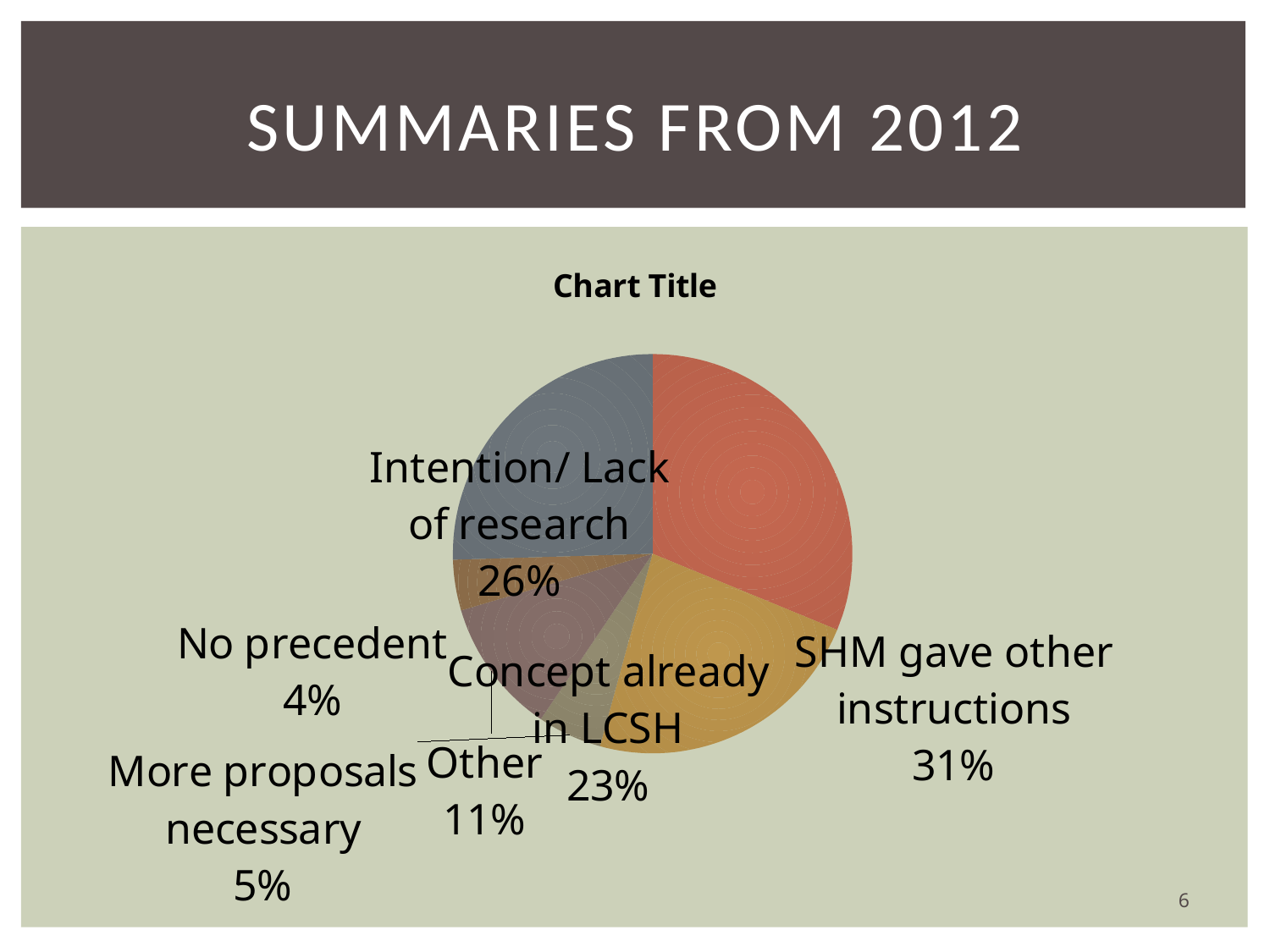
What is the title printed above the pie chart? Chart Title What is the difference in percentage points between "SHM gave other instructions" and "Concept already in LCSH"? 8 What share of the pie is labelled "SHM gave other instructions"? 31% What percentage is shown for "Intention/ Lack of research"? 26% What kind of chart is shown on the slide? Pie chart Which slice of the pie is the largest? SHM gave other instructions What percentage is shown for "Concept already in LCSH"? 23% Which is larger, "More proposals necessary" or "No precedent"? More proposals necessary Which slice of the pie is the smallest? No precedent How many slices does the pie chart have? 6 What percentage is shown for "Other"? 11% What percentage is shown for "No precedent"? 4%